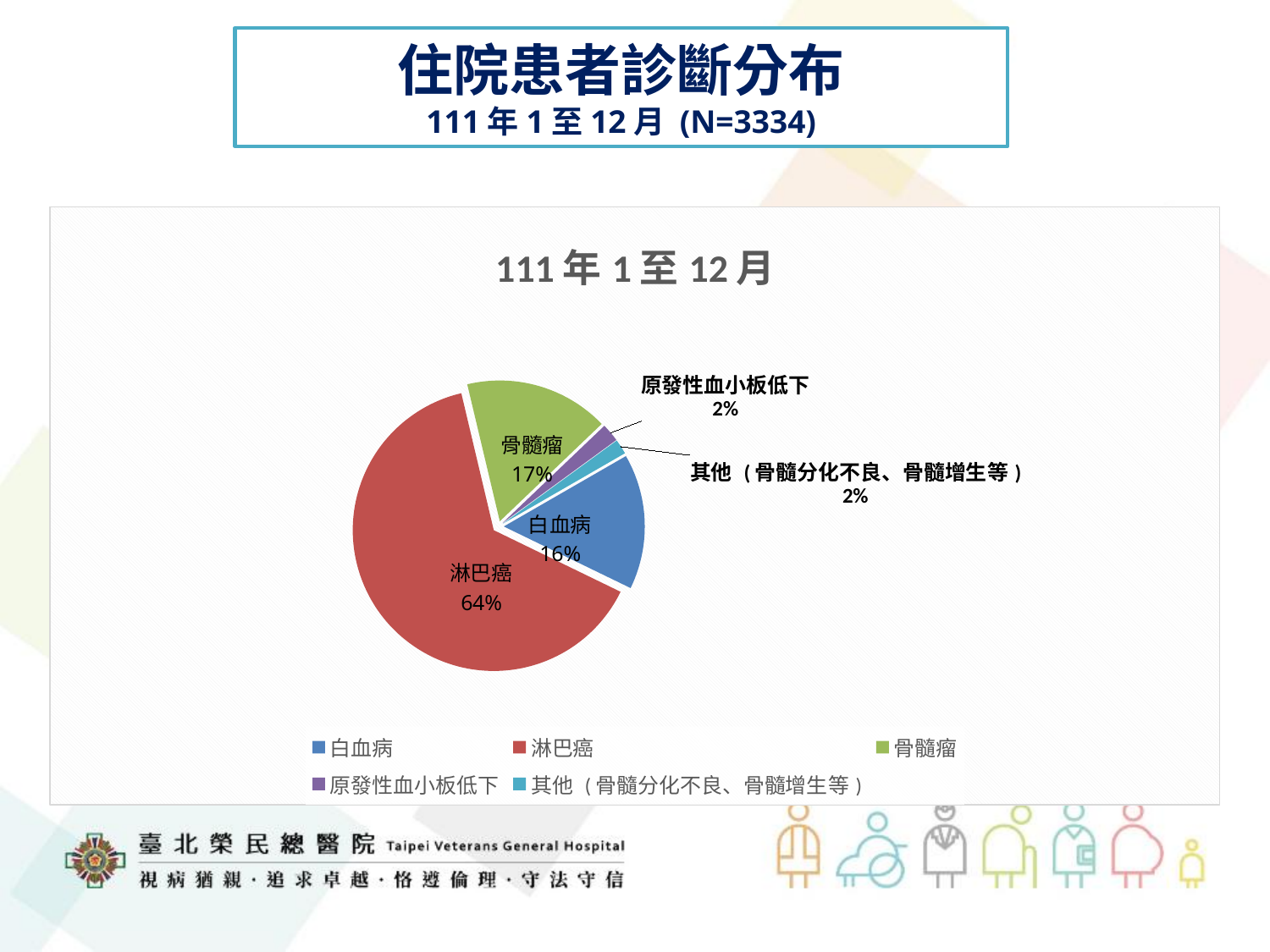
What percentage of the pie does 白血病 represent? 16% What colour is the 淋巴癌 slice? red Which is larger, the share for 骨髓瘤 or the share for 白血病? 骨髓瘤 What type of chart is shown on the slide? pie chart Which category has the largest share of the pie? 淋巴癌 What percentage of the pie does 淋巴癌 represent? 64% What percentage of the pie does 原發性血小板低下 represent? 2% What is the difference in percentage points between 淋巴癌 and 白血病? 48 How many categories does the legend list? 5 What is the chart's title? 111 年 1 至 12 月 What is the combined share of 白血病 and 骨髓瘤? 33% What percentage of the pie does 骨髓瘤 represent? 17%